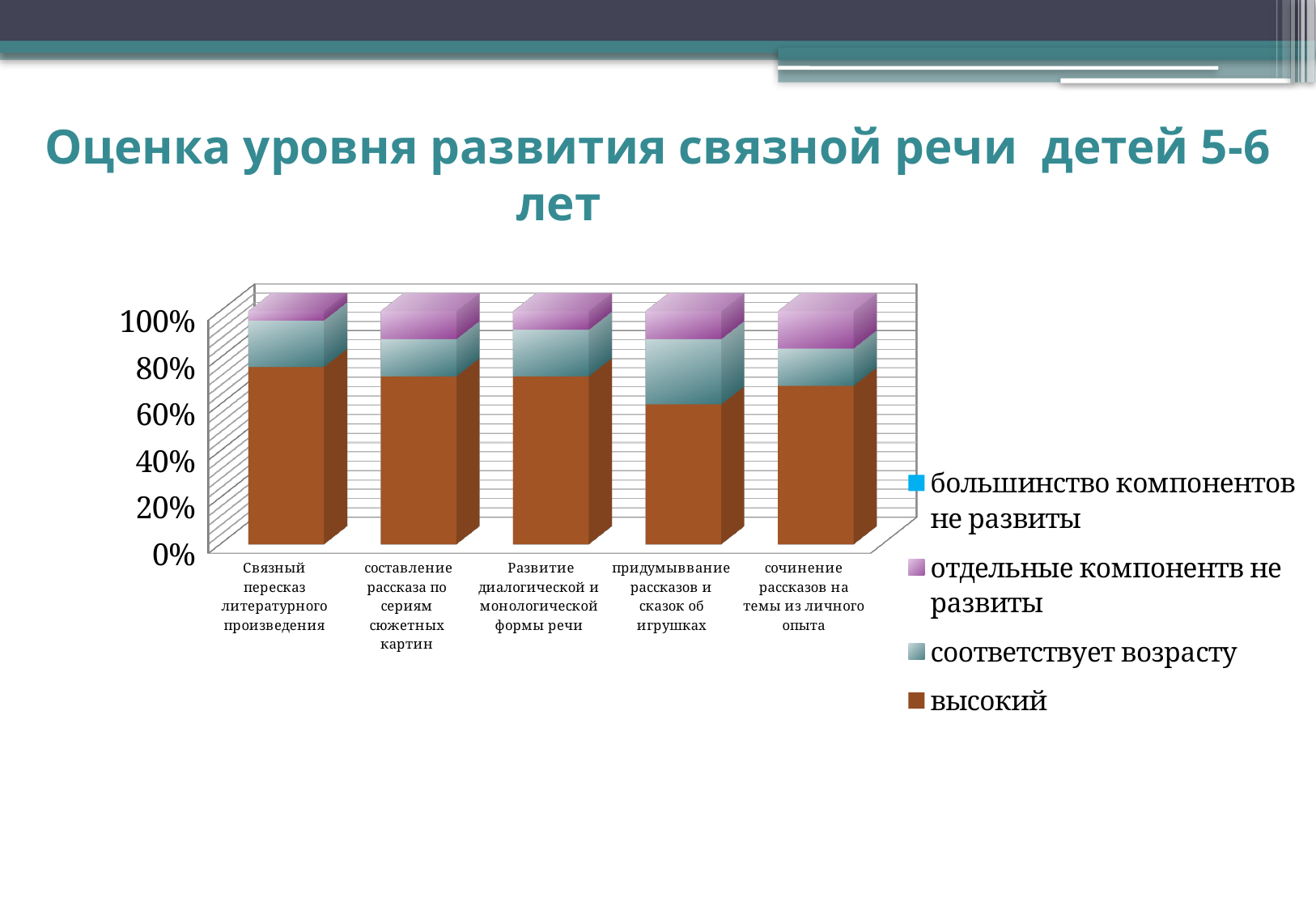
Which category has the smallest 'высокий' share? придумыввание рассказов и сказок об игрушках Which category has the largest 'высокий' share? Связный пересказ литературного произведения What is the title of the slide containing the chart? Оценка уровня развития связной речи детей 5-6 лет Is the 'высокий' share for 'Связный пересказ литературного произведения' greater or less than 60%? greater Which series is drawn in brown in the chart? высокий How many categories are shown along the x axis of the chart? 5 How many series does the chart legend list? 4 What kind of chart is shown on the slide? stacked bar chart Which has the larger 'высокий' share: 'Связный пересказ литературного произведения' or 'придумыввание рассказов и сказок об игрушках'? Связный пересказ литературного произведения Is the 'высокий' share for 'придумыввание рассказов и сказок об игрушках' greater or less than 80%? less Is the 'высокий' share for 'придумыввание рассказов и сказок об игрушках' greater or less than 40%? greater